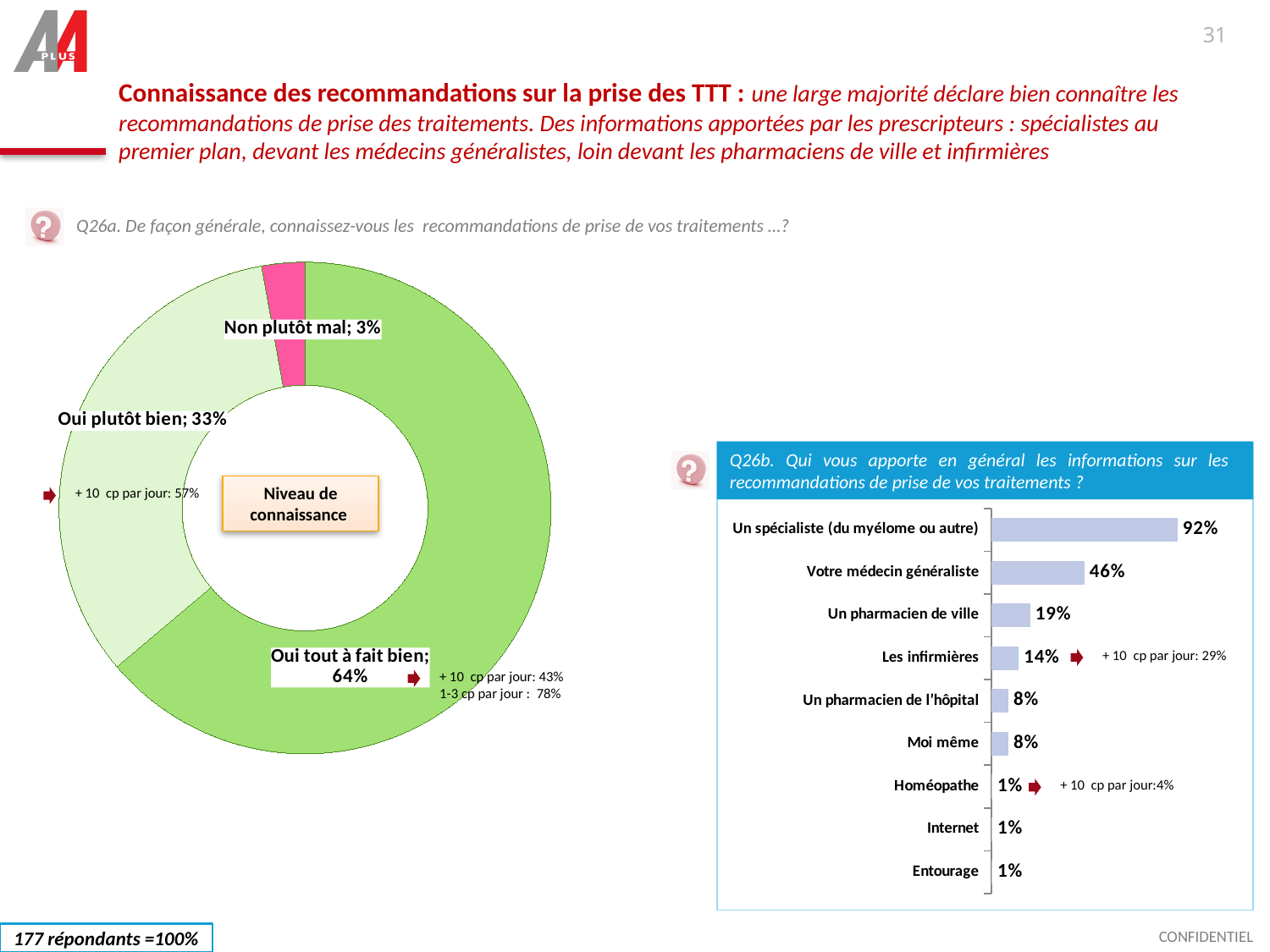
In the bar chart on the right (Q26b), what is the value for "Votre médecin généraliste"? 46% What type of chart is shown on the right side of the slide (Q26b)? Bar chart In the donut chart on the left, how many slices are there? 3 In the donut chart on the left, what share of respondents answered "Non plutôt mal"? 3% In the donut chart on the left (Niveau de connaissance), what share of respondents answered "Oui tout à fait bien"? 64% In the bar chart on the right (Q26b), which is larger: "Un pharmacien de ville" or "Un pharmacien de l'hôpital"? Un pharmacien de ville In the bar chart on the right (Q26b), what is the value for "Les infirmières"? 14% In the bar chart on the right (Q26b), what is the difference between "Un spécialiste (du myélome ou autre)" and "Votre médecin généraliste"? 46 percentage points In the donut chart on the left, which category has the smallest share? Non plutôt mal In the bar chart on the right (Q26b), which category has the highest value? Un spécialiste (du myélome ou autre) In the donut chart on the left, what is the difference between the shares for "Oui tout à fait bien" and "Oui plutôt bien"? 31 percentage points In the bar chart on the right (Q26b), how many categories are shown? 9